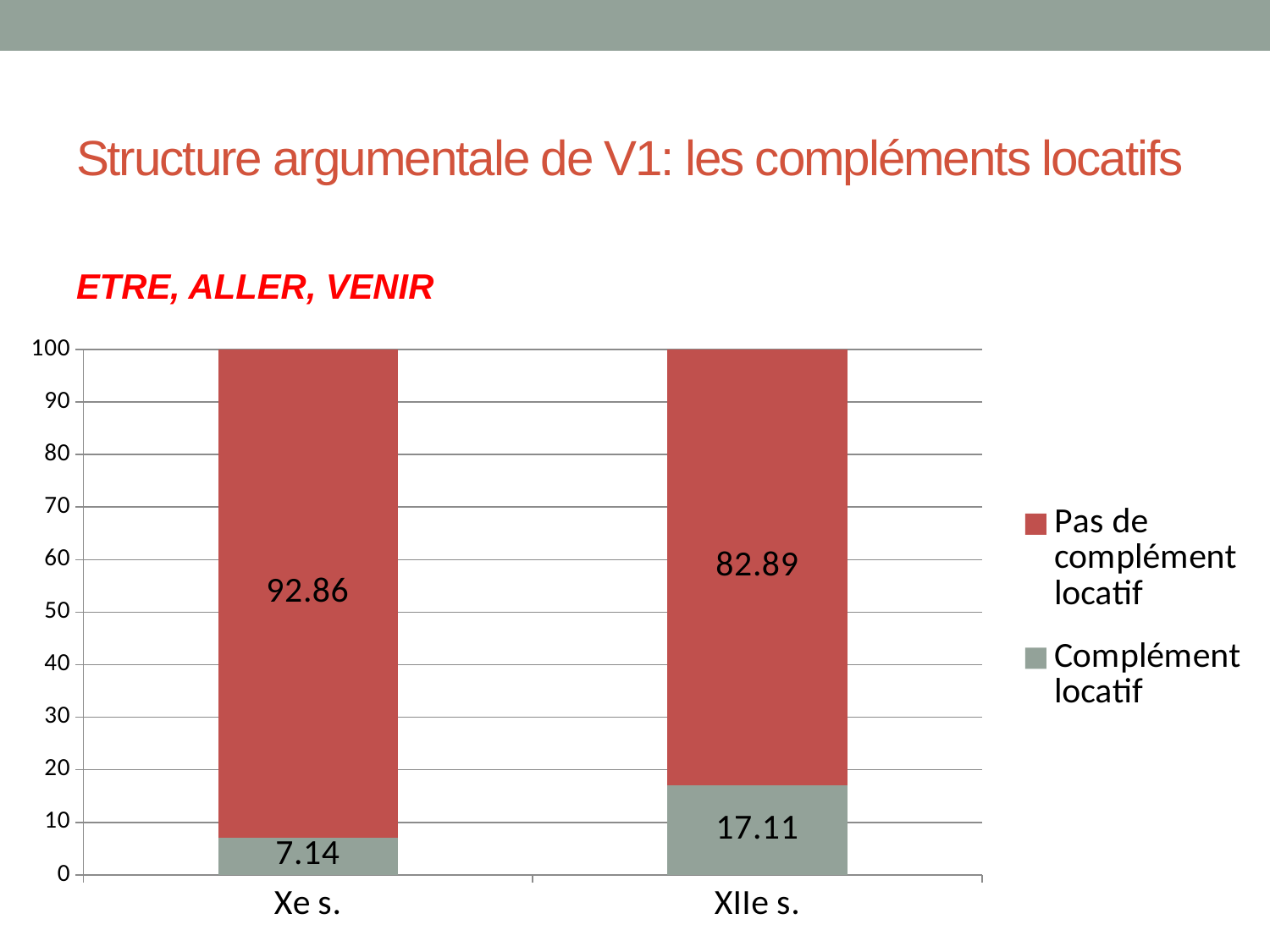
What is the value for "Complément locatif" in the Xe s. bar? 7.14 What kind of chart is shown on the slide? stacked bar chart Which category has the higher value for "Complément locatif"? XIIe s. What is the difference between the "Complément locatif" values for XIIe s. and Xe s.? 9.97 What is the total of the stacked bar for Xe s.? 100 Is the "Pas de complément locatif" value for Xe s. larger or smaller than that for XIIe s.? larger Which category has the lower value for "Pas de complément locatif"? XIIe s. What is the value for "Pas de complément locatif" in the XIIe s. bar? 82.89 What is the value for "Complément locatif" in the XIIe s. bar? 17.11 How many series does the legend list? 2 What is the value for "Pas de complément locatif" in the Xe s. bar? 92.86 How many categories are shown on the x axis? 2